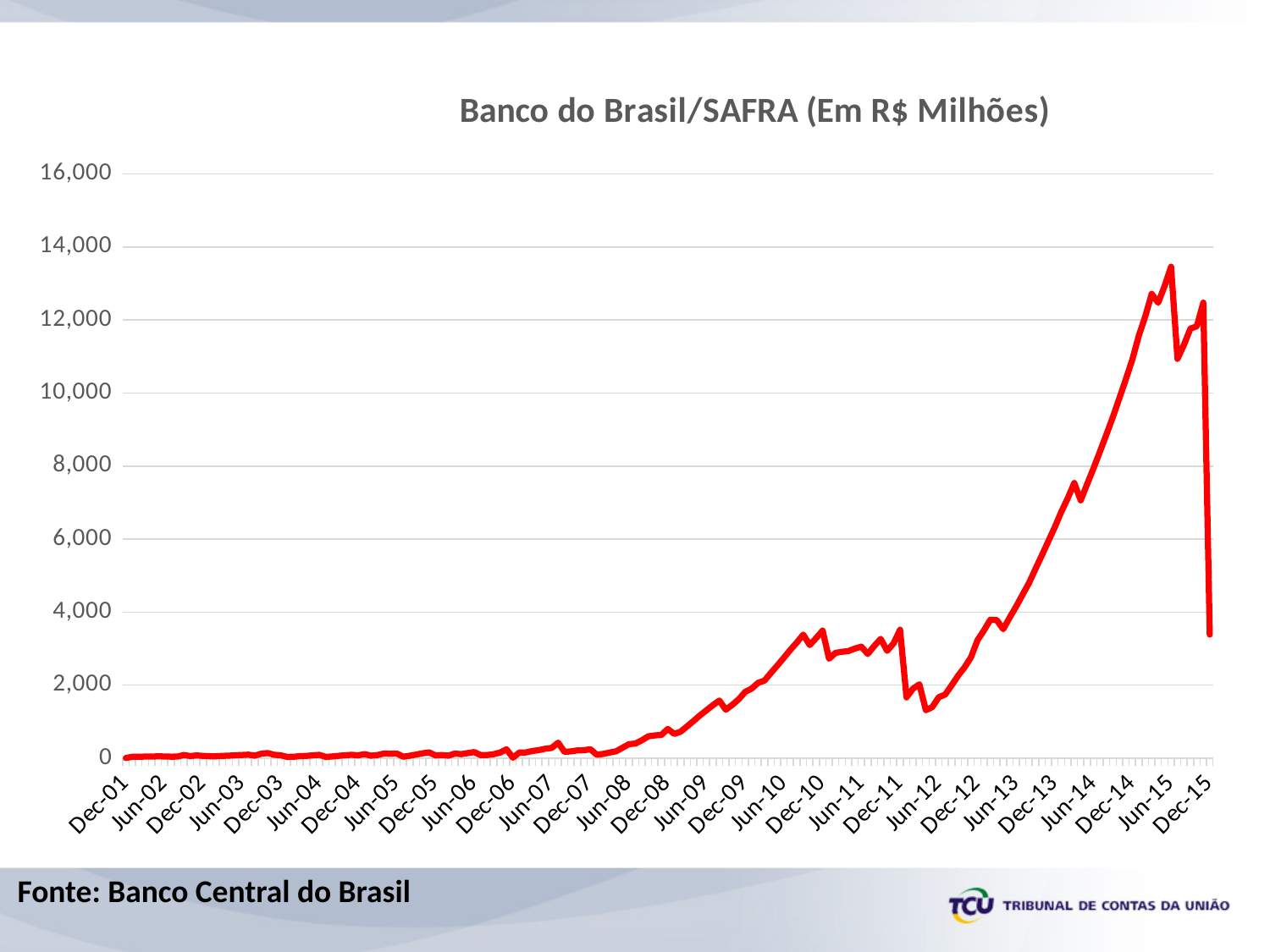
Is the value for Jun-14 greater or less than 6,000? greater Is the value for Jun-15 greater or less than 12,000? greater Is the value for Dec-12 greater or less than 4,000? less What is the title of the chart? Banco do Brasil/SAFRA (Em R$ Milhões) What source is cited below the chart? Fonte: Banco Central do Brasil Overall, do the values rise or fall from Dec-01 to Jun-15? rise What kind of chart is shown on the slide? line chart Do the values rise or fall between Jun-15 and Dec-15? fall